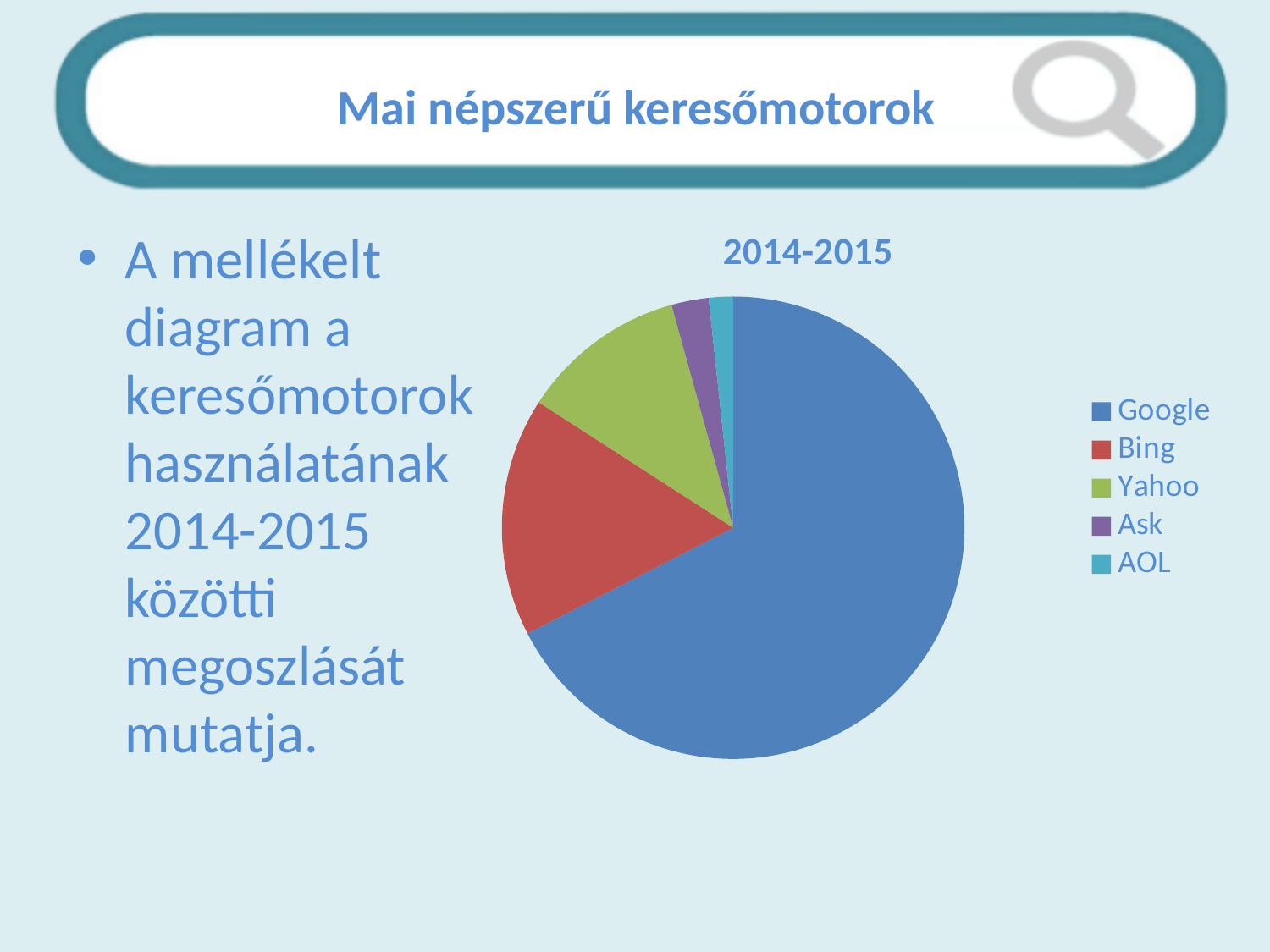
How many slices does the pie chart have? 5 Which search engine is represented by the red slice? Bing Which has a larger share of the pie, Google or Bing? Google How many search engines are listed in the chart's legend? 5 What kind of chart is shown on the slide? pie chart Which search engine has the second-largest slice of the pie? Bing Which search engine has the largest slice of the pie? Google Which has a larger share of the pie, Yahoo or Ask? Yahoo Which has a larger share of the pie, Bing or Yahoo? Bing Which search engine has the smallest slice of the pie? AOL What is the title of the chart? 2014-2015